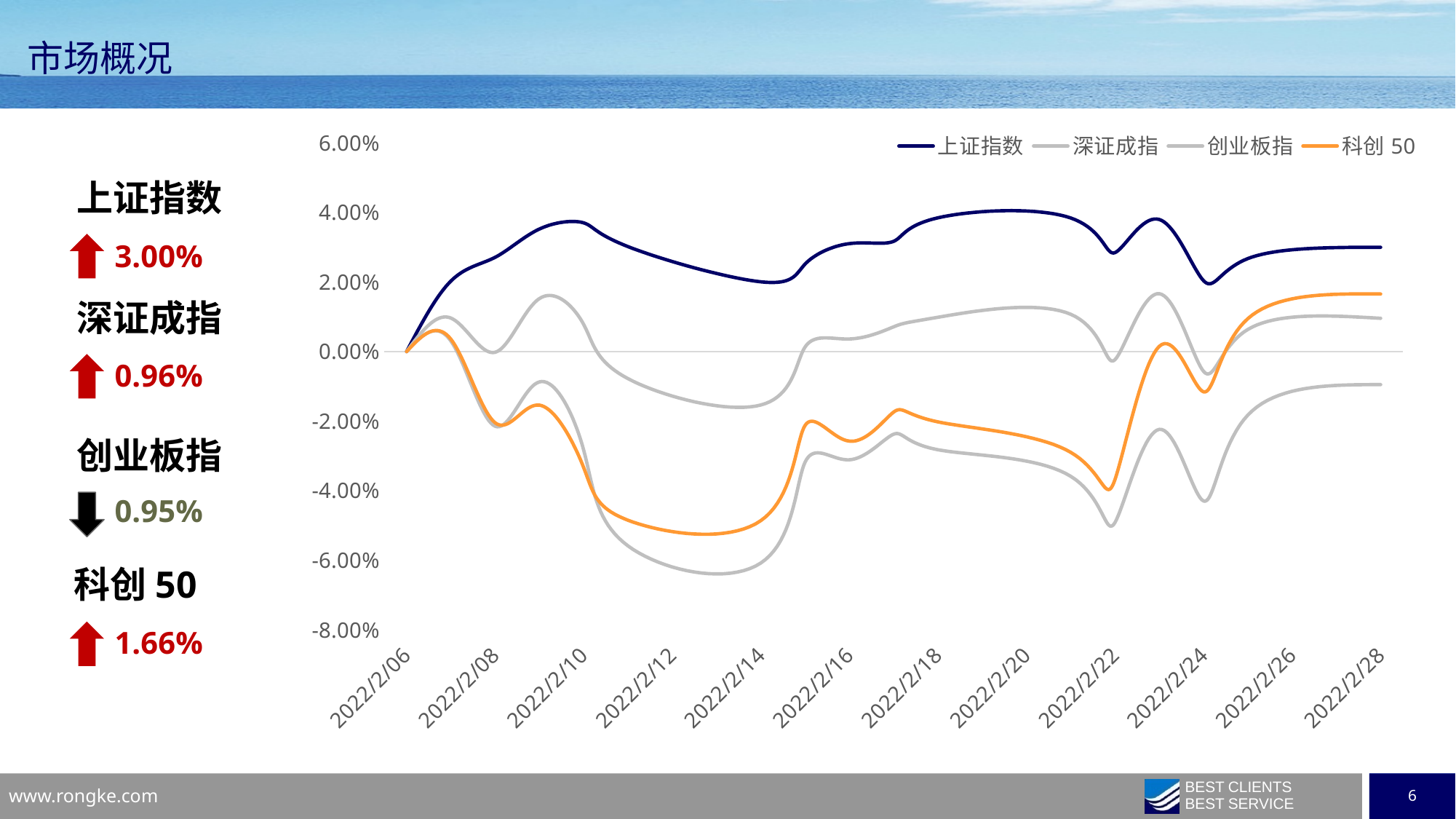
How many date labels are shown on the x axis? 12 Which series is drawn in dark navy blue in the chart? 上证指数 Which index has the largest change listed on the left of the slide? 上证指数 Does the 上证指数 line rise or fall between 2022/2/06 and 2022/2/10? rise How many series does the chart legend list? 4 What kind of chart is shown on the slide? line chart According to the figures on the left of the slide, what is the change for 上证指数? 3.00% Is the value of 科创 50 around 2022/2/12 greater or less than -4.00%? less What is the difference between the listed changes for 上证指数 (3.00%) and 深证成指 (0.96%)? 2.04% Which series is drawn in orange in the chart? 科创 50 According to the figures on the left of the slide, what is the change for 科创 50? 1.66% Which of the four indices listed on the left shows a decline (down arrow)? 创业板指